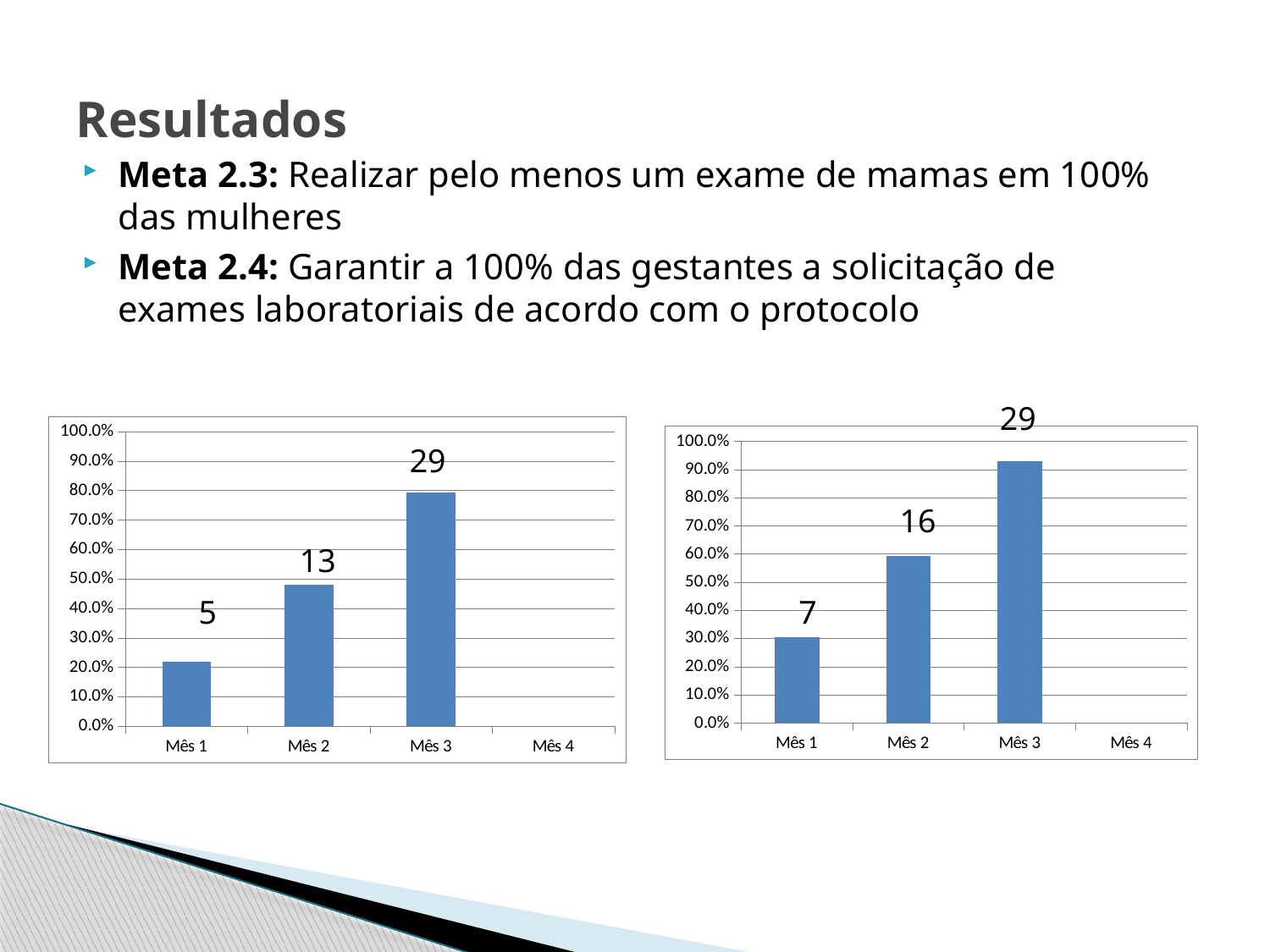
In the right chart, is the labelled value for Mês 2 larger or smaller than the labelled value for Mês 1? larger In the left chart, which month has the highest bar? Mês 3 In the right chart, what is the data label shown for Mês 2? 16 In the left chart, what is the data label shown for Mês 1? 5 In the right chart, what is the difference between the labelled values for Mês 3 and Mês 1? 22 In the right chart, which month has the lowest labelled value? Mês 1 In the right chart, is the bar for Mês 3 greater or less than 90.0% on the vertical axis? greater How many month categories are shown on the x axis of the left chart? 4 What type of chart is the right chart? bar chart In the left chart, what is the difference between the labelled values for Mês 3 and Mês 2? 16 In the left chart, what is the data label shown for Mês 3? 29 In the left chart, is the bar for Mês 1 greater or less than 30.0% on the vertical axis? less